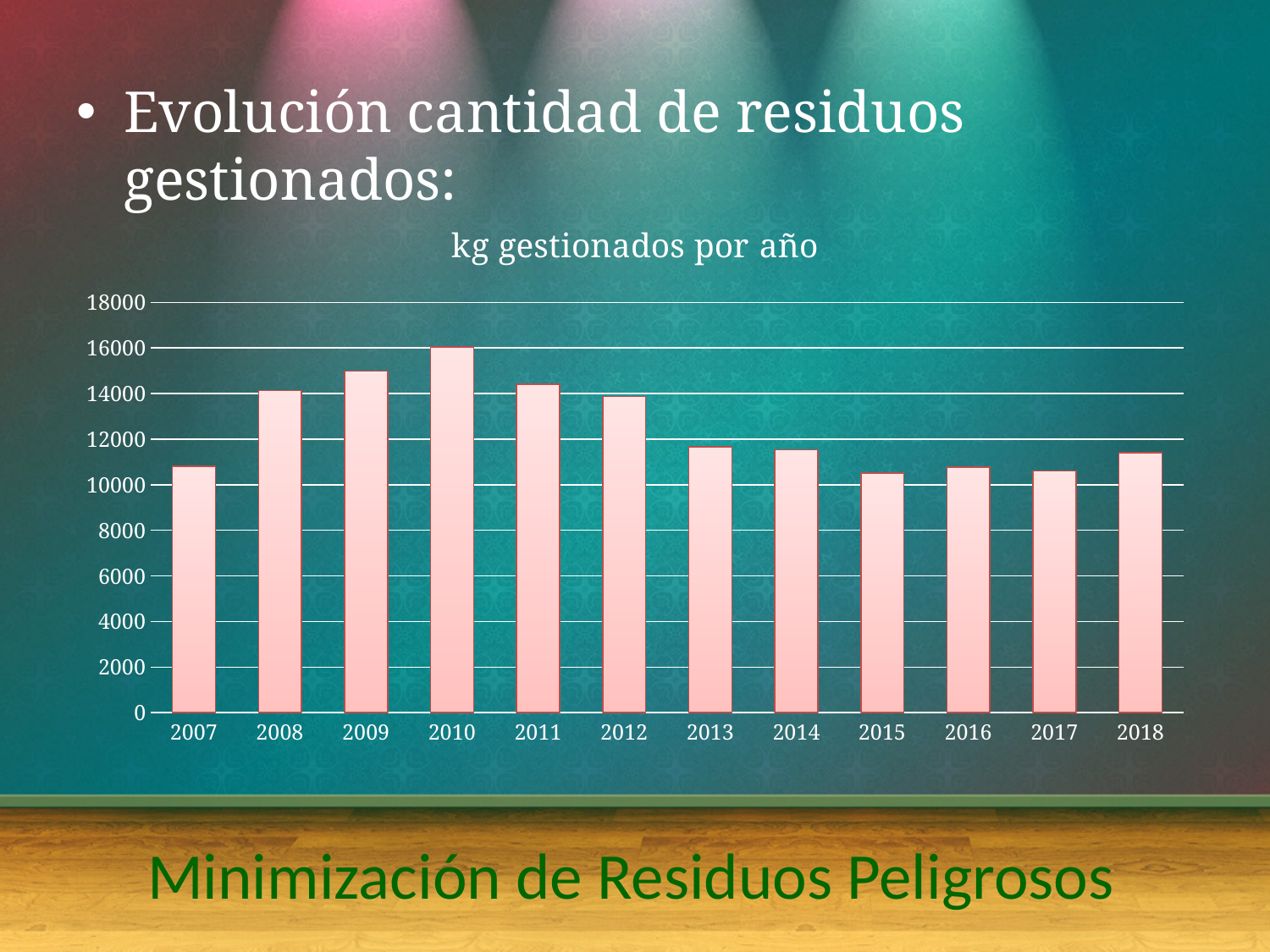
Is the value for 2015 greater or less than 12000? less Which year has the larger value, 2011 or 2018? 2011 How many years are shown on the x axis of the chart? 12 What is the title of the chart? kg gestionados por año Is the value for 2013 greater or less than 12000? less Is the value for 2010 greater or less than 14000? greater Which year has the larger value, 2009 or 2012? 2009 Do the values rise or fall from 2007 to 2010? rise Which year has the highest value in the chart? 2010 What kind of chart is shown on the slide? bar chart